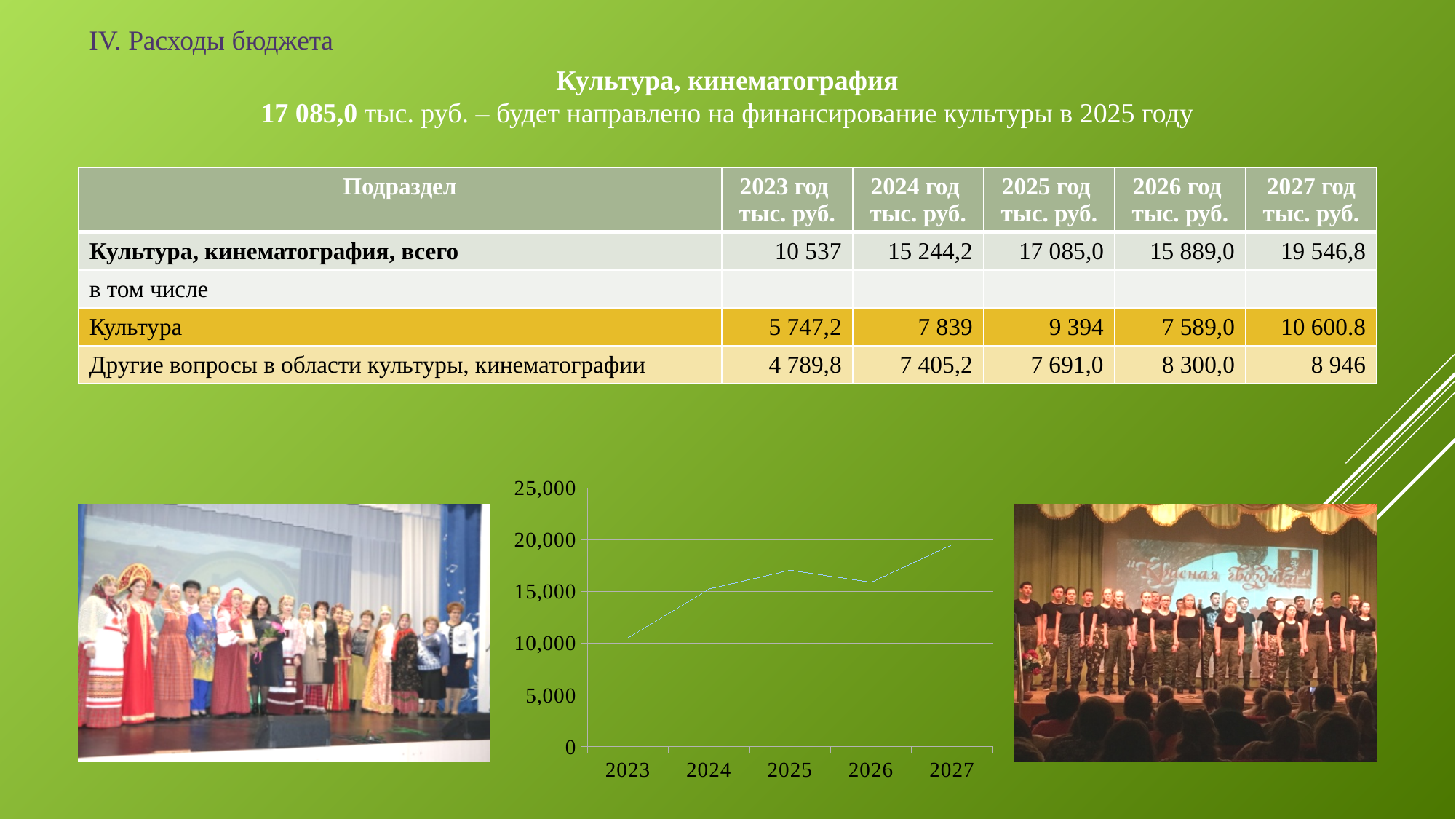
How many years are plotted along the x axis of the line chart? 5 On the line chart, which is larger, the value for 2025 or the value for 2026? 2025 Is the value for 2027 on the line chart greater or less than 15,000? greater Does the line on the chart rise or fall between 2025 and 2026? fall Which year has the lowest value on the line chart? 2023 On the line chart, which is larger, the value for 2024 or the value for 2023? 2024 Which year has the highest value on the line chart? 2027 What is the highest value shown on the y axis of the line chart? 25,000 Is the value for 2023 on the line chart greater or less than 10,000? greater What kind of chart is shown on the slide? line chart Is the value for 2025 on the line chart greater or less than 20,000? less